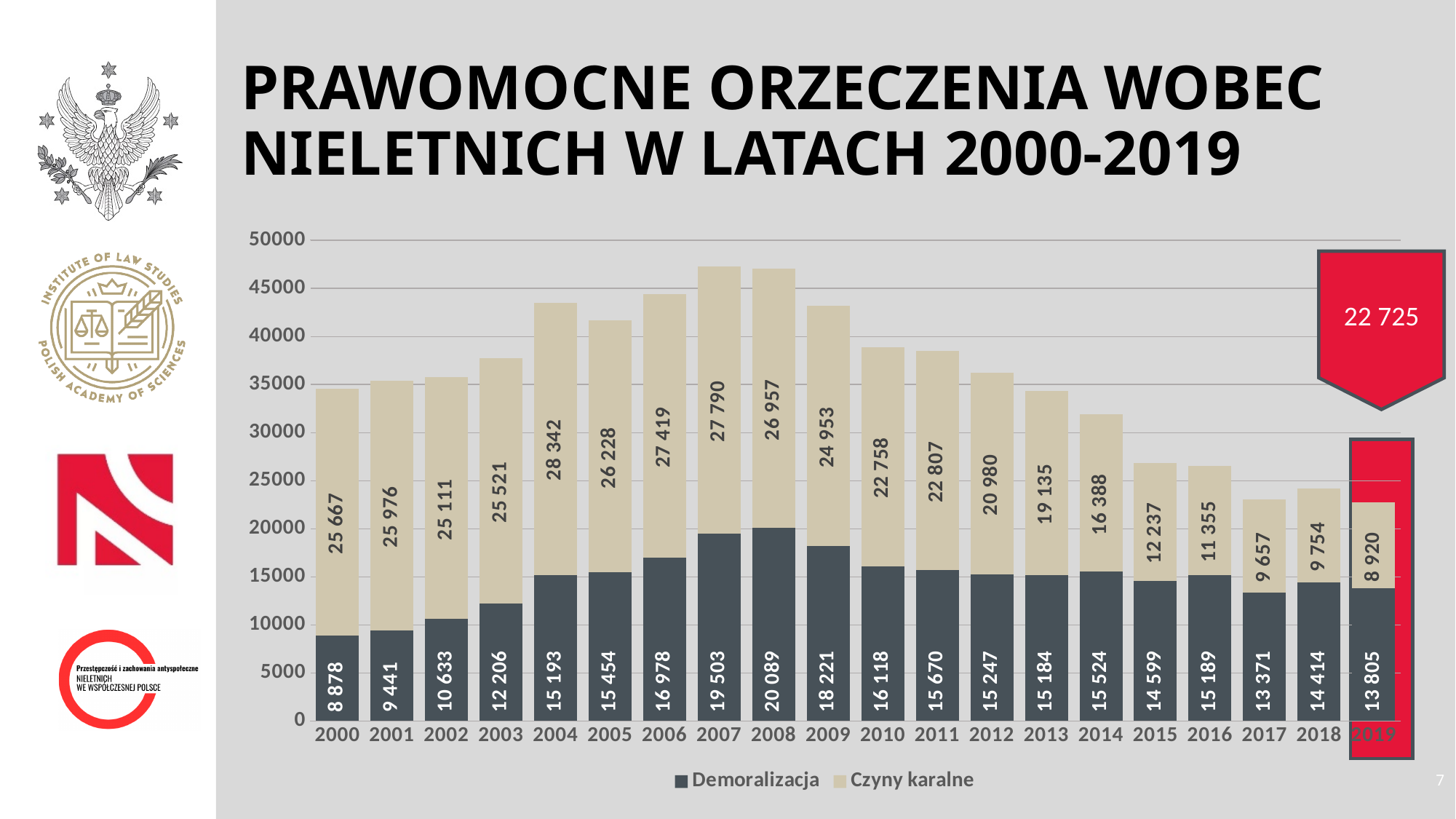
What is the total of the stacked bar for 2019? 22 725 What is the value of Czyny karalne for 2019? 8 920 What is the value of Demoralizacja for 2008? 20 089 In which year is the Demoralizacja value highest? 2008 How many years are shown on the x axis? 20 What is the difference between the Czyny karalne values for 2004 and 2019? 19 422 In which year is the Czyny karalne value lowest? 2019 What kind of chart is shown on the slide? Stacked bar chart Which is larger, the Demoralizacja value for 2007 or for 2009? 2007 How many series does the legend list? 2 What is the value of Czyny karalne for 2004? 28 342 Is the total of the stacked bar for 2007 greater or less than 45000? greater